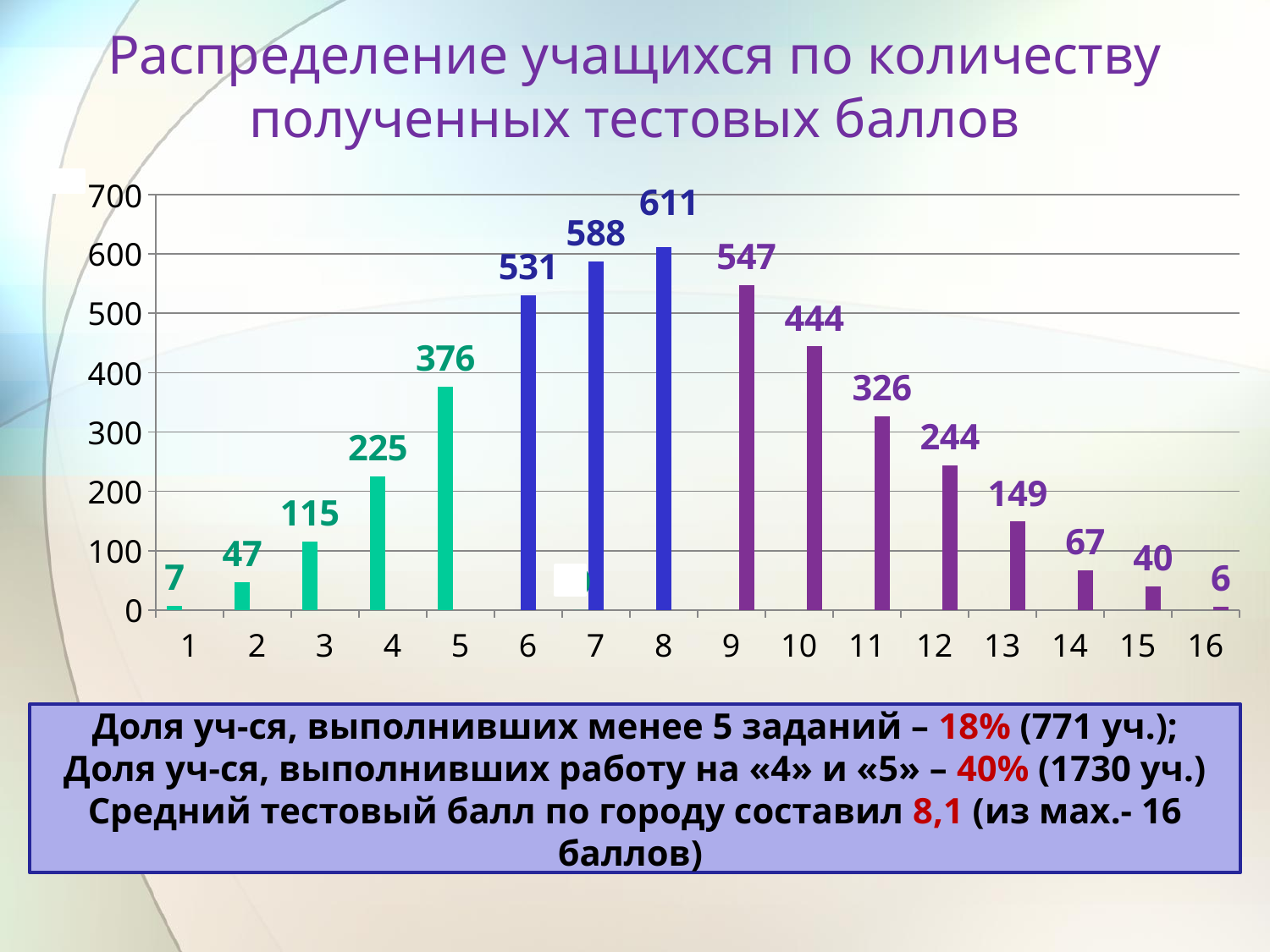
Do the values rise or fall from category 9 to category 16? fall What is the difference between the values for category 7 and category 6? 57 What is the value for category 13? 149 Which category has the lowest value? 16 What is the value for category 8? 611 How many categories are shown on the x axis? 16 What is the title of the chart? Распределение учащихся по количеству полученных тестовых баллов Which category has the highest value? 8 What is the value for category 5? 376 Which is larger, the value for category 9 or the value for category 10? category 9 What type of chart is shown on the slide? bar chart What is the difference between the values for category 4 and category 3? 110